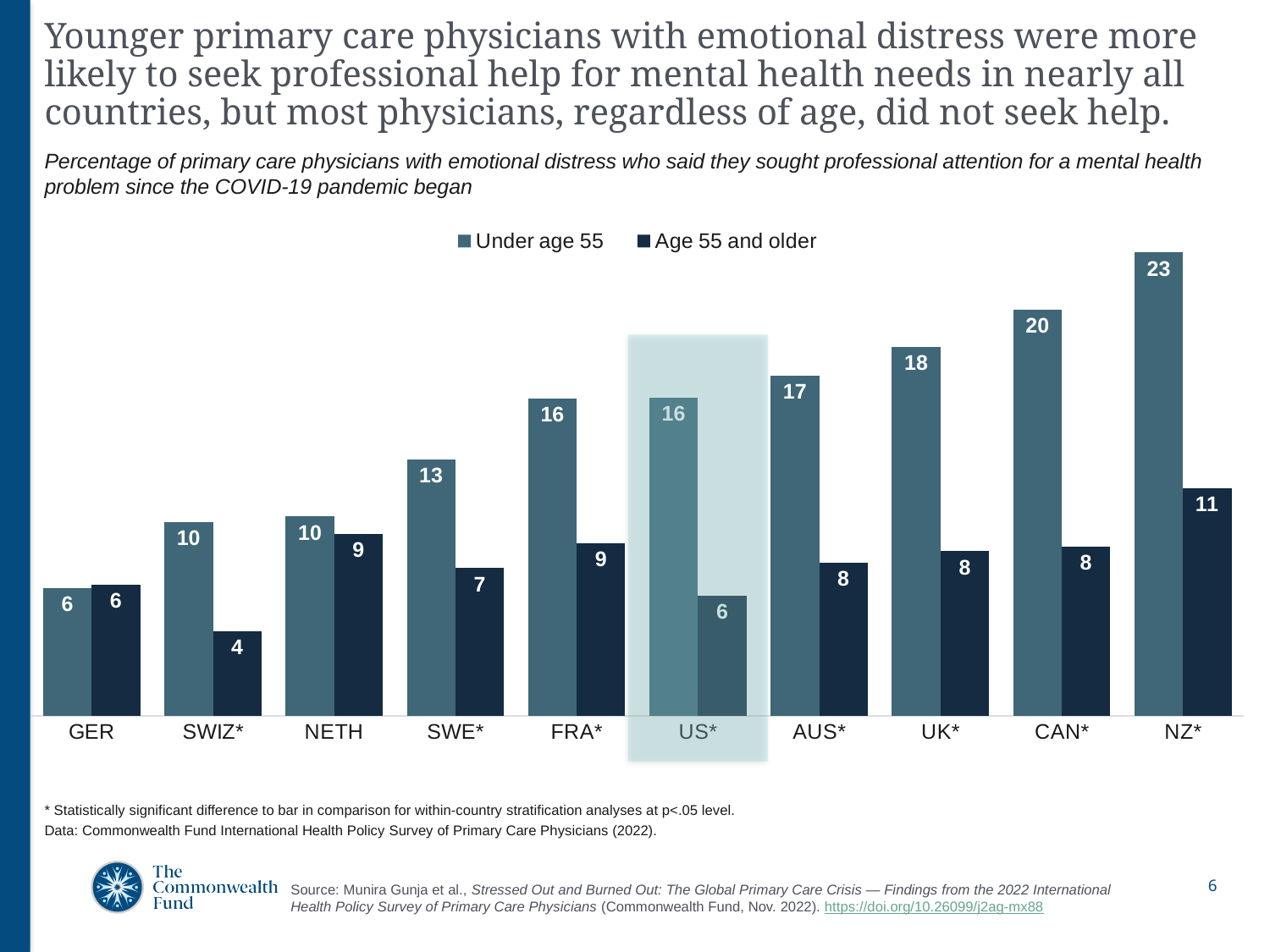
Which country has the highest value for Under age 55? NZ* What is the value for Under age 55 in NZ*? 23 Which is larger in NETH: the Under age 55 value or the Age 55 and older value? Under age 55 In which country are the Under age 55 and Age 55 and older values equal? GER What is the value for Age 55 and older in US*? 6 Which country has the lowest value for Age 55 and older? SWIZ* What kind of chart is shown on the slide? Bar chart How many series does the legend list? 2 What is the difference between the Under age 55 and Age 55 and older values for CAN*? 12 Which country is highlighted with a shaded background? US* What is the value for Age 55 and older in SWIZ*? 4 How many countries are shown on the x axis? 10